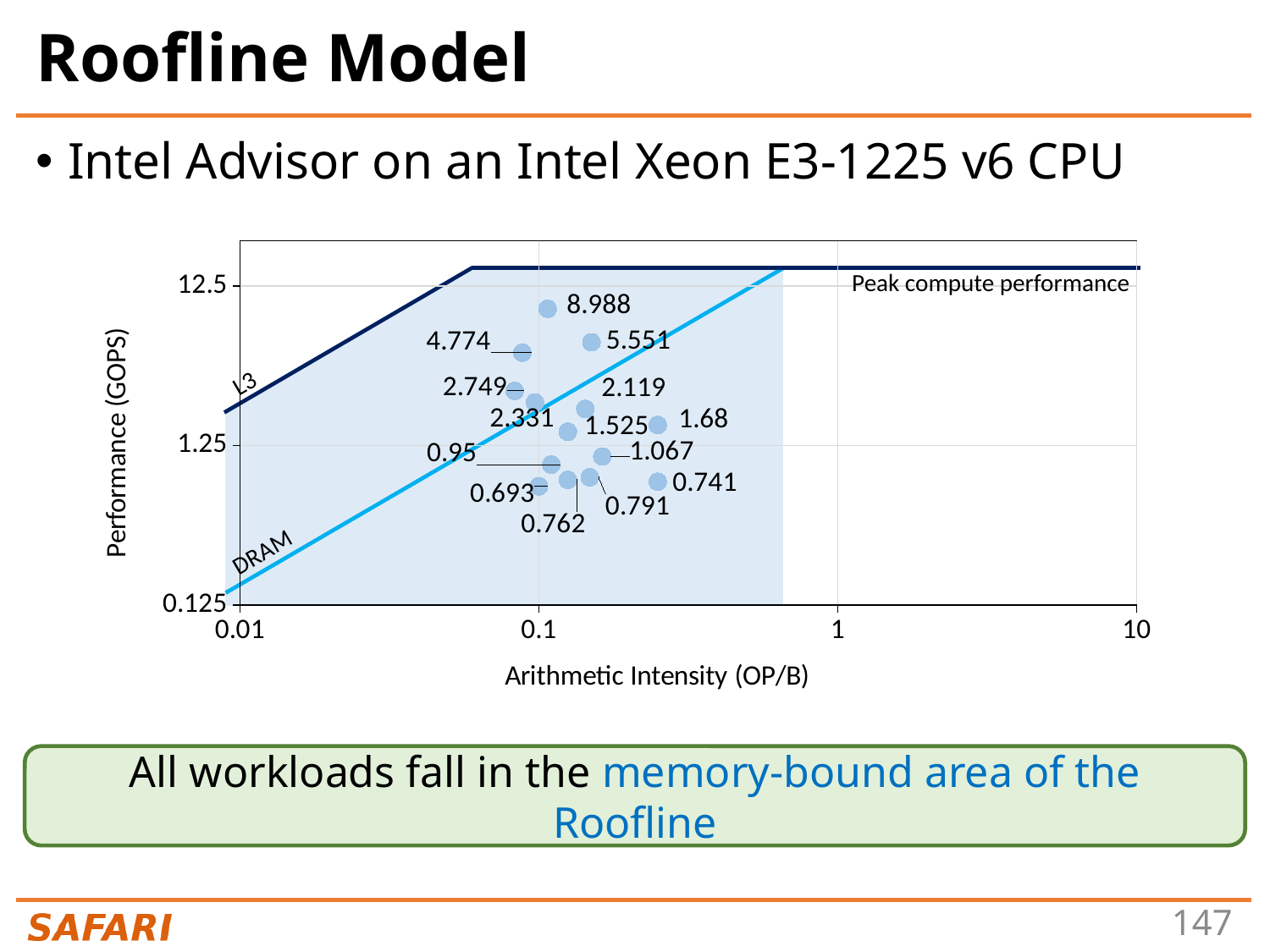
What is the highest data label value among the plotted workload points? 8.988 What kind of chart is shown on the slide? scatter chart How many labelled workload points are plotted on the chart? 14 Is the performance of the point labelled 0.741 greater or less than 1.25 GOPS? less Is the performance of the point labelled 8.988 greater or less than 12.5 GOPS? less Which labelled point has the larger performance value, 4.774 or 5.551? 5.551 What label is given to the horizontal line at the top of the chart? Peak compute performance What is the difference between the labelled values 1.067 and 0.95? 0.117 Is the performance of the point labelled 2.749 greater or less than 1.25 GOPS? greater What is the lowest data label value among the plotted workload points? 0.693 What is the difference between the two highest labelled points, 8.988 and 5.551? 3.437 What is the title of the x axis of the chart? Arithmetic Intensity (OP/B)